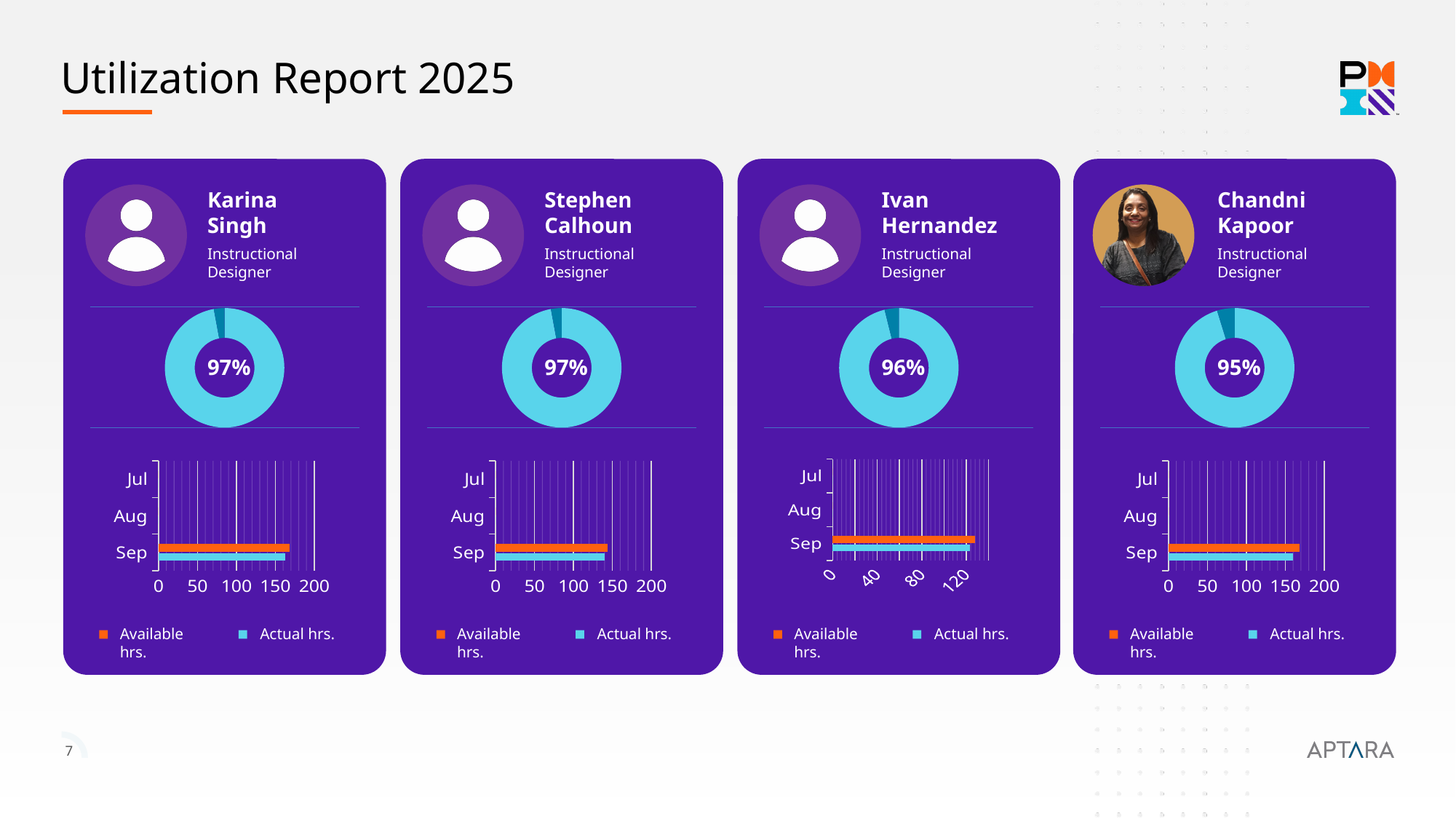
On Karina Singh's bar chart, is the Available hrs. value for Sep greater or less than 150? greater On Chandni Kapoor's card, what percentage is shown in the centre of the doughnut chart? 95% What is the difference between Karina Singh's utilization percentage and Chandni Kapoor's? 2 percentage points How many series does the legend list on Stephen Calhoun's bar chart? 2 On Ivan Hernandez's card, what percentage is shown in the centre of the doughnut chart? 96% On Ivan Hernandez's bar chart, is the Available hrs. value for Sep greater or less than 80? greater On Karina Singh's card, what percentage is shown in the centre of the doughnut chart? 97% How many month categories are listed on the y axis of Chandni Kapoor's bar chart? 3 On Stephen Calhoun's bar chart, is the Actual hrs. value for Sep greater or less than 100? greater What type of chart is shown below the doughnut on Karina Singh's card? Bar chart Which is larger: the utilization percentage for Ivan Hernandez or for Chandni Kapoor? Ivan Hernandez Across the four cards, which person has the lowest utilization percentage in their doughnut chart? Chandni Kapoor